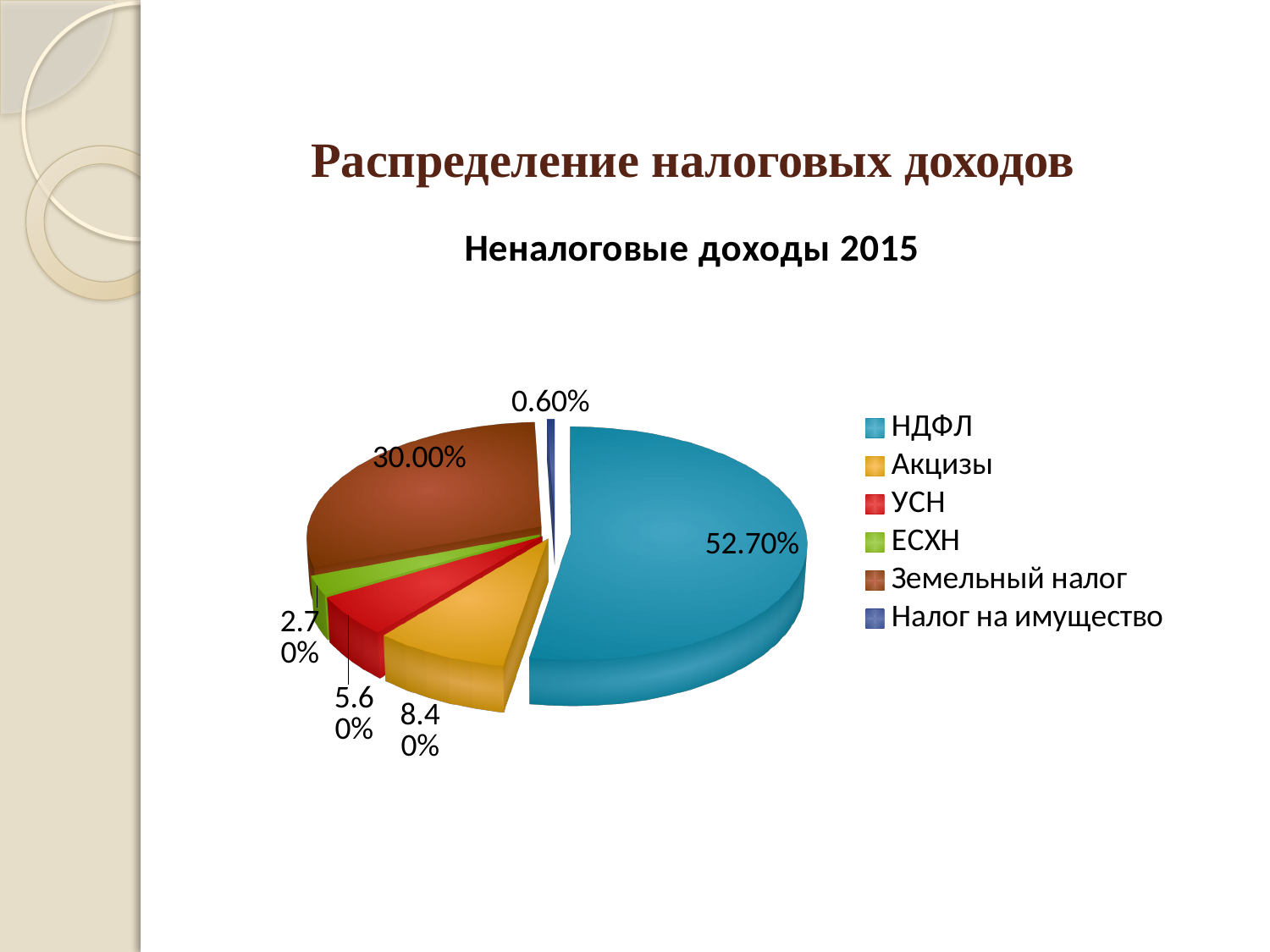
What share of the pie does Земельный налог have? 30.00% Which category has the largest share of the pie? НДФЛ What share of the pie does Налог на имущество have? 0.60% What is the title of the chart? Неналоговые доходы 2015 What share of the pie does НДФЛ have? 52.70% What kind of chart is shown on the slide? pie chart What share of the pie does УСН have? 5.60% Which is larger, the share of Акцизы or the share of ЕСХН? Акцизы How many categories does the legend list? 6 Which category has the smallest share of the pie? Налог на имущество What is the difference between the shares of НДФЛ and Земельный налог? 22.70% What share of the pie does Акцизы have? 8.40%